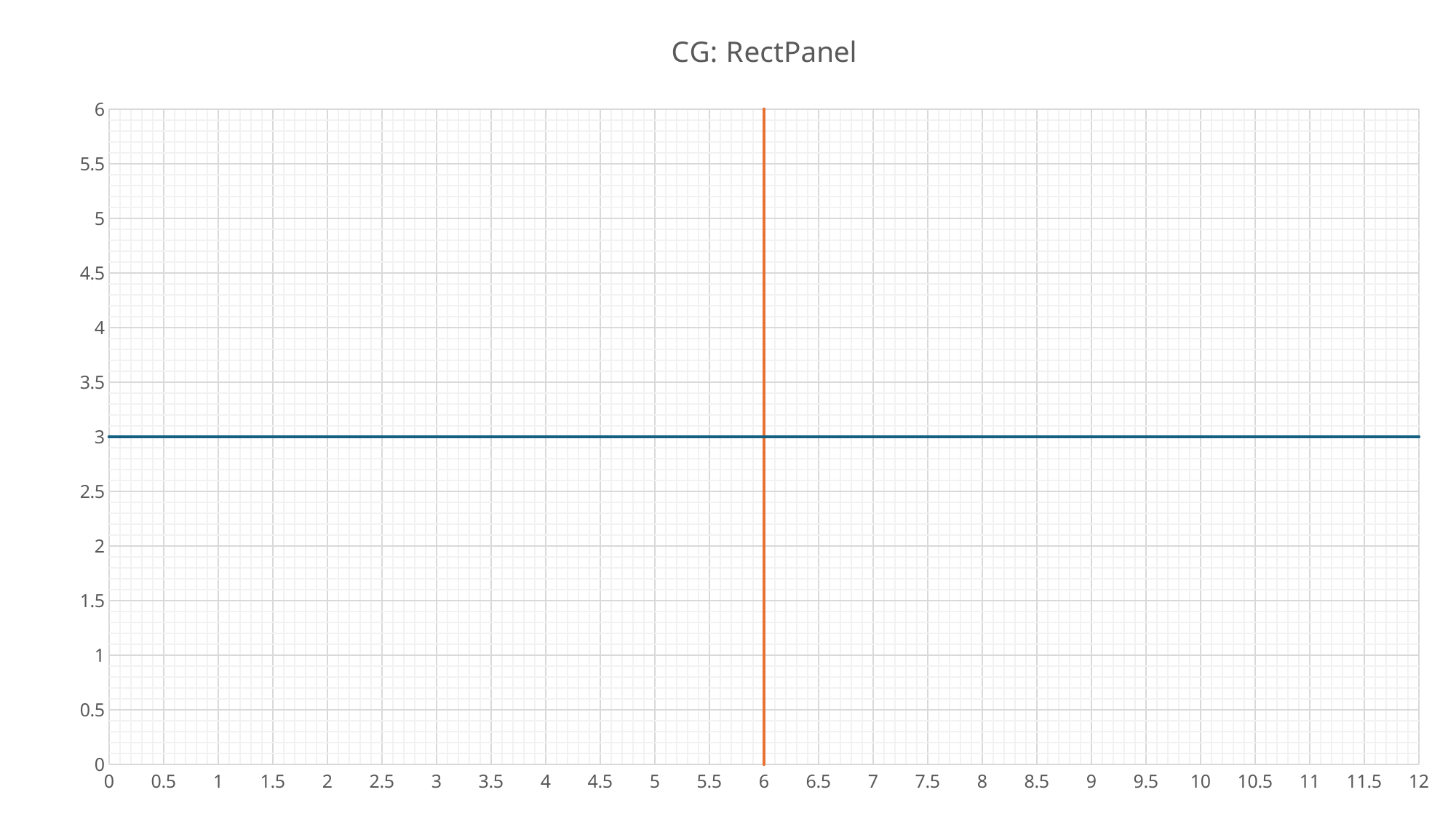
What is the difference between the vertical line's x value and the horizontal line's y value? 3 What is the title of the chart? CG: RectPanel At what x-axis value does the vertical orange line sit? 6 Is the y value of the horizontal blue line greater or less than 4? less Is the x position of the vertical orange line greater or less than 5? greater At what y-axis value does the horizontal blue line sit? 3 Which line is positioned at a larger axis value: the horizontal line's y value or the vertical line's x value? the vertical line's x value What kind of chart is shown on the slide? line chart What is the maximum value shown on the y axis? 6 How many lines are plotted on the chart? 2 Does the horizontal blue line rise, fall, or stay flat along the x axis? stay flat